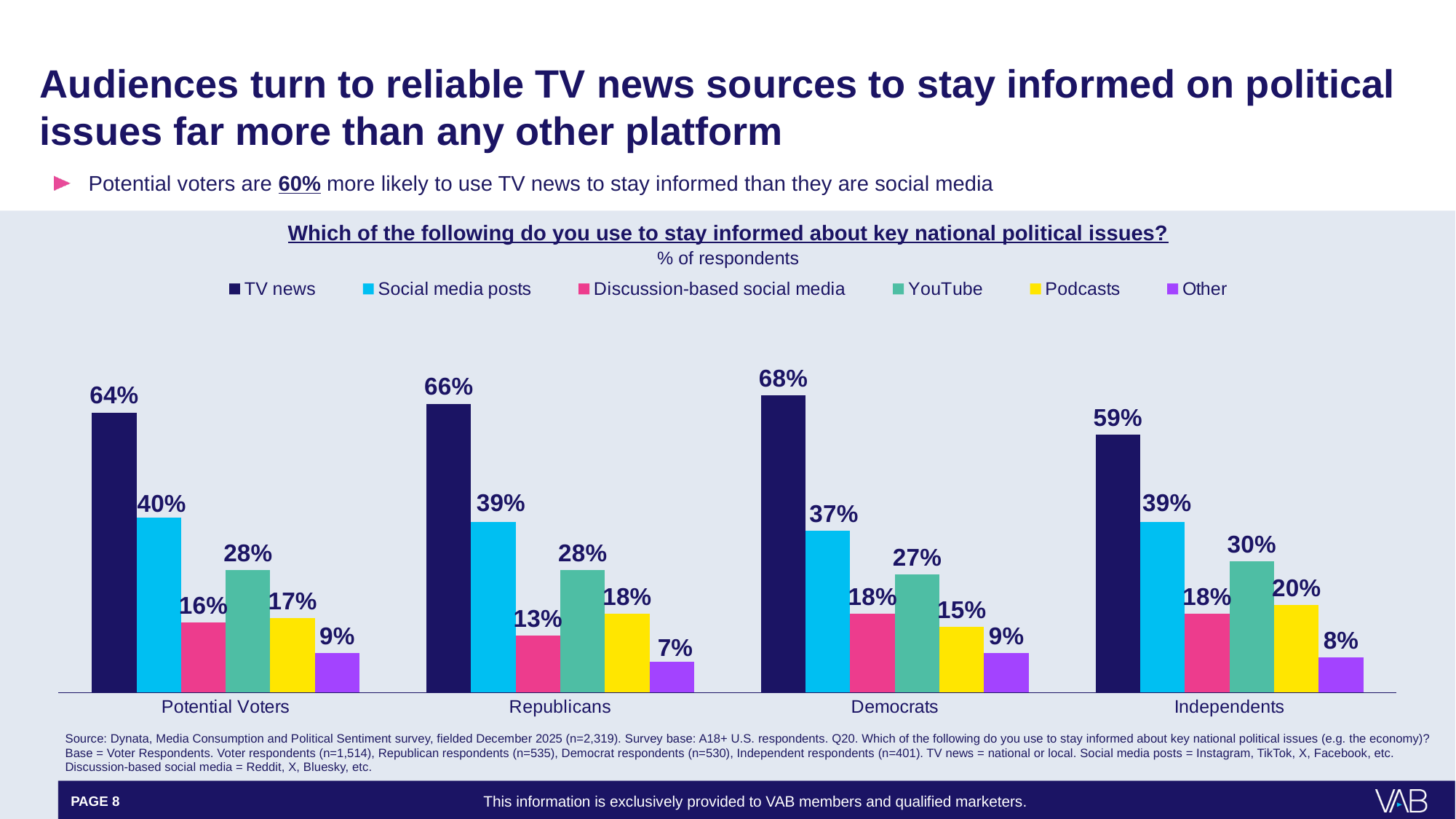
How many series does the legend list? 6 Which is larger for Independents: YouTube or Podcasts? YouTube What percentage of Independents use Podcasts to stay informed? 20% Which source has the lowest value among Republicans? Other What is the difference between TV news and Social media posts for Potential Voters? 24 percentage points Which group has the highest value for TV news? Democrats What percentage of Republicans use Discussion-based social media? 13% Which series is shown in yellow in the legend? Podcasts How many groups are shown on the x axis? 4 What percentage of Democrats use TV news to stay informed about key national political issues? 68% What kind of chart is shown on the slide? Bar chart What is the difference between Democrats and Independents for TV news? 9 percentage points